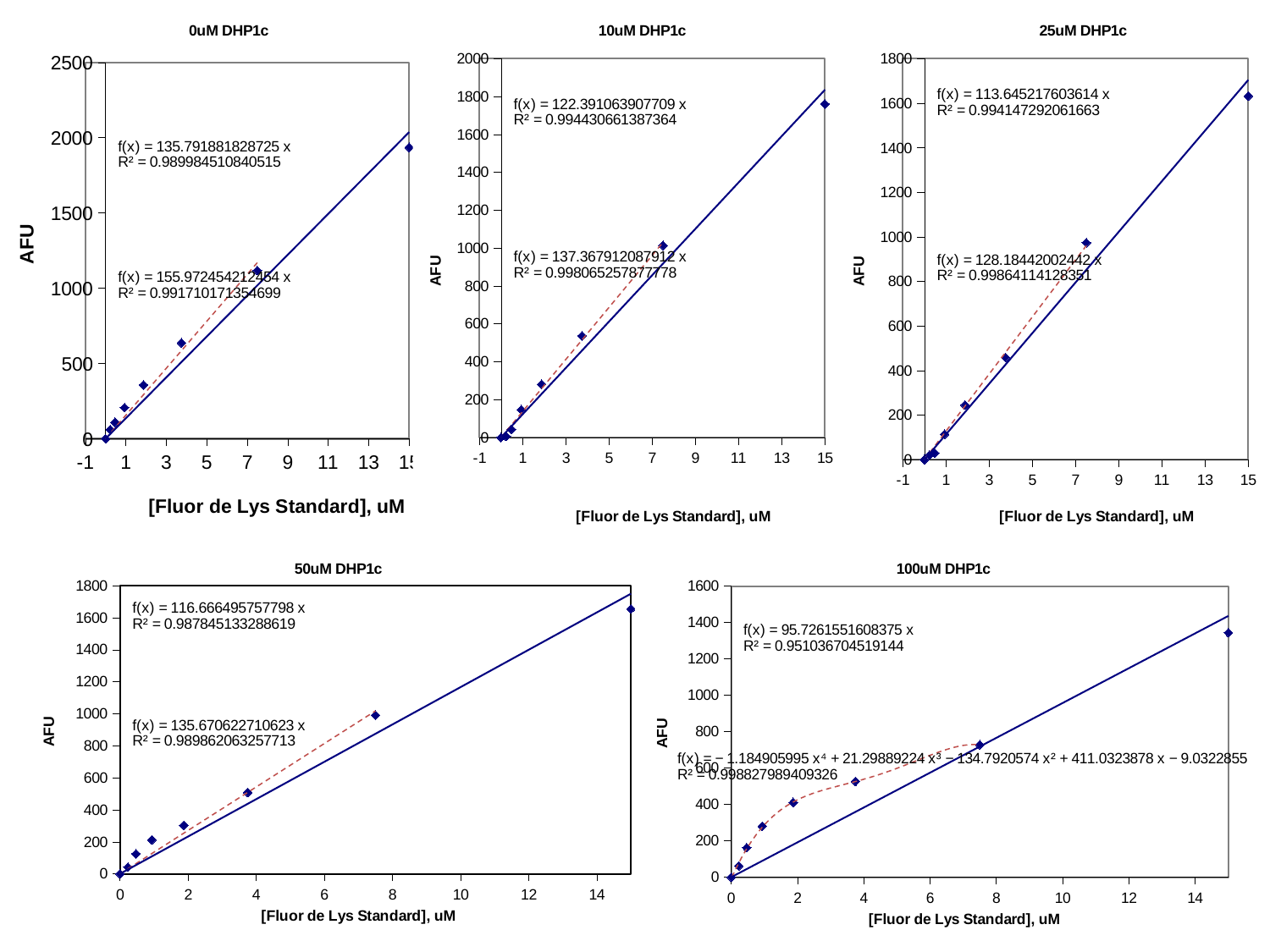
In the 10uM DHP1c chart, is the AFU value at 15 uM greater or less than 1600? greater In the 100uM DHP1c chart, what is the R² value of the linear fit f(x) = 95.7261551608375 x? 0.951036704519144 What is the y-axis title of the 25uM DHP1c chart? AFU Which chart has the higher AFU value at 15 uM, the 0uM DHP1c chart or the 100uM DHP1c chart? 0uM DHP1c In the 100uM DHP1c chart, is the AFU value at 15 uM greater or less than 1000? greater How many charts are shown on the slide? 5 In the 25uM DHP1c chart, is the AFU value at 15 uM greater or less than 1400? greater What is the x-axis title of the 50uM DHP1c chart? [Fluor de Lys Standard], uM In the 100uM DHP1c chart, do the AFU values rise or fall as the Fluor de Lys Standard concentration increases? rise What kind of chart is the 0uM DHP1c chart? Scatter chart